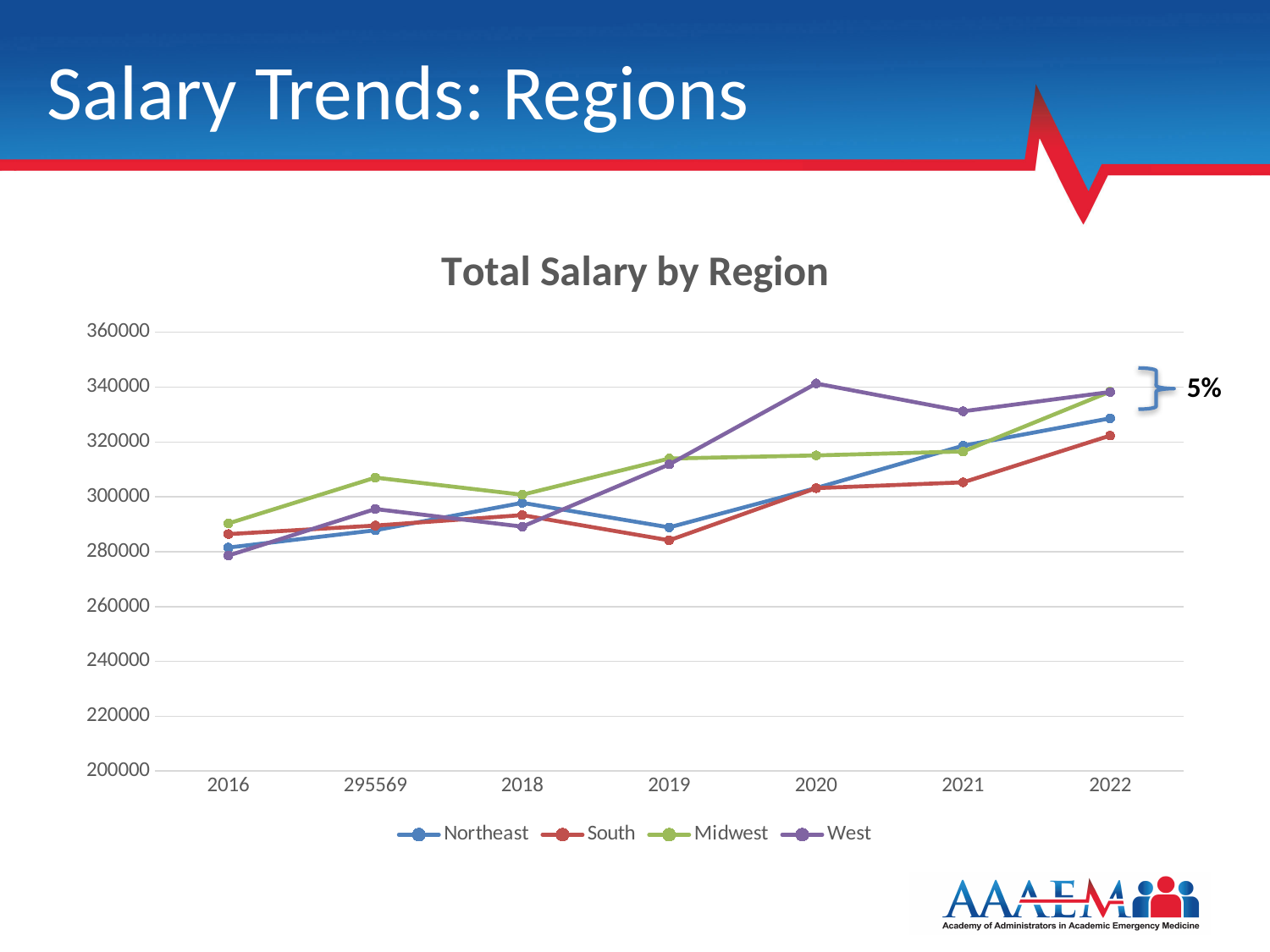
In 2020, which is larger, the value for West or the value for South? West How many points along the x axis does each line have? 7 Which region has the highest value at the second x-axis point (labelled 295569)? Midwest Is the value for South in 2019 greater or less than 300000? less Which region has the highest value in 2020? West Is the value for West in 2020 greater or less than 320000? greater Does the Northeast line rise or fall from 2019 to 2022? rise What percentage is shown next to the bracket at the right end of the lines? 5% What kind of chart is shown on the slide? Line chart What is the title of the chart? Total Salary by Region Which region has the lowest value in 2019? South How many series does the legend list? 4